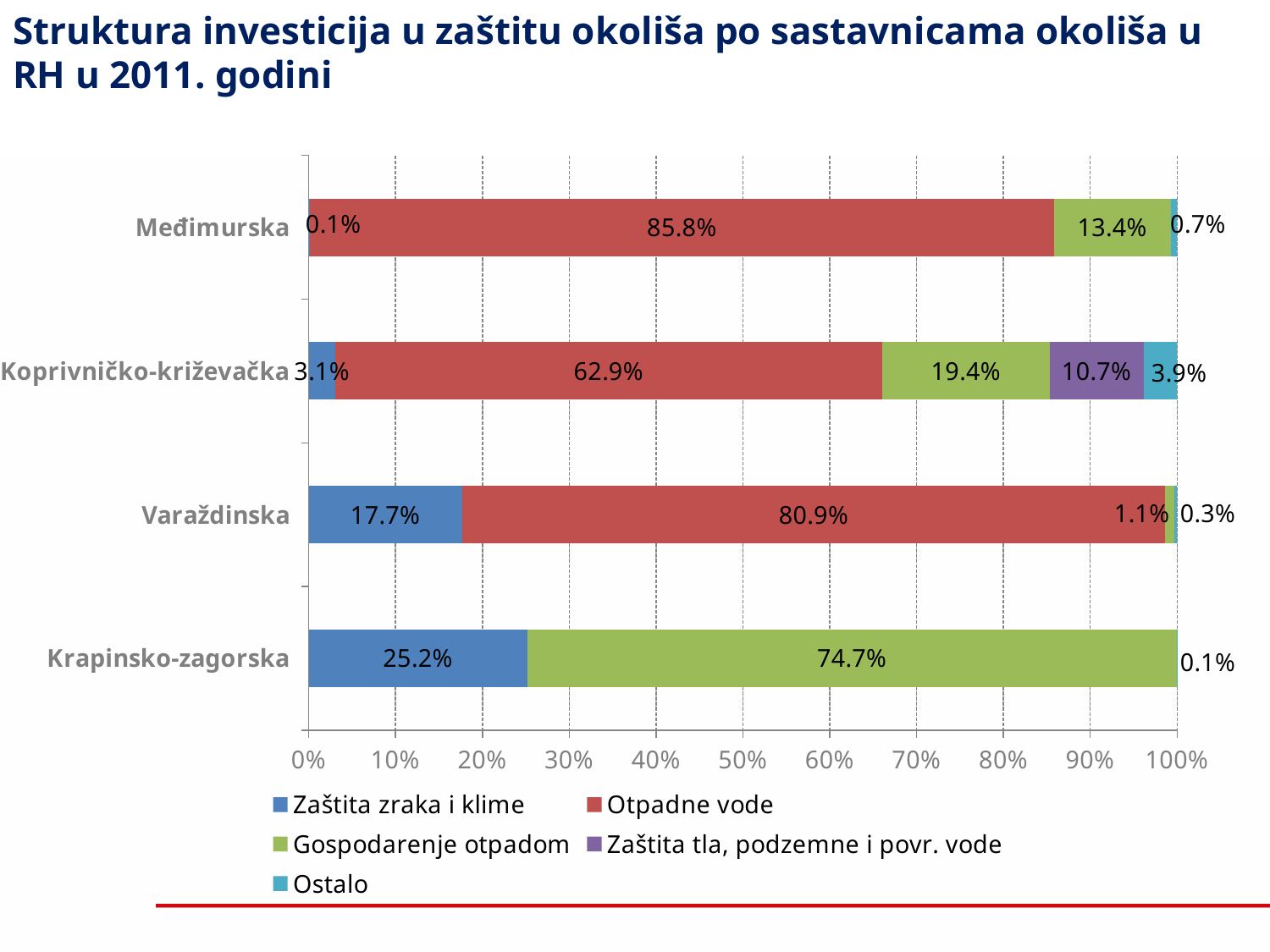
What is the share of Zaštita zraka i klime for Krapinsko-zagorska? 25.2% How many counties are shown on the chart? 4 What is the share of Zaštita tla, podzemne i povr. vode for Koprivničko-križevačka? 10.7% What kind of chart is shown on the slide? Stacked bar chart What is the share of Ostalo for Koprivničko-križevačka? 3.9% Which county has the highest share of Zaštita zraka i klime? Krapinsko-zagorska What is the difference between the Otpadne vode share for Međimurska and for Varaždinska? 4.9 percentage points Which county has the highest share of Otpadne vode? Međimurska Which has a larger Gospodarenje otpadom share, Koprivničko-križevačka or Međimurska? Koprivničko-križevačka What is the share of Otpadne vode for Međimurska? 85.8% How many series does the legend list? 5 Which series is shown in red in the legend? Otpadne vode